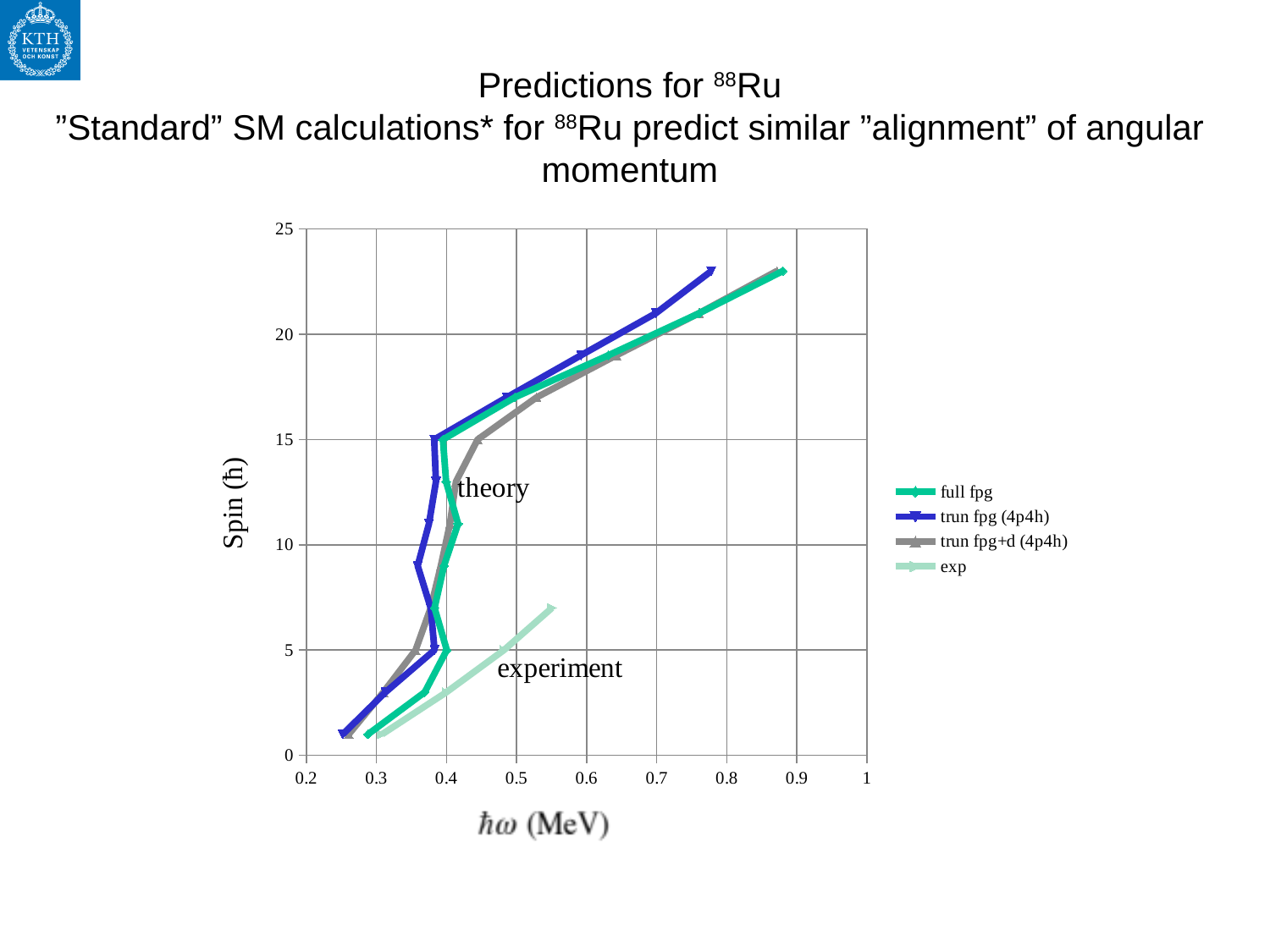
Is the ħω value of the full fpg series at spin 23 greater or less than 0.8 MeV? greater What are the four series listed in the legend? full fpg, trun fpg (4p4h), trun fpg+d (4p4h), exp At spin 23, which series has the larger ħω value: full fpg or trun fpg (4p4h)? full fpg How many data points does the exp series have? 4 Is the ħω value of the trun fpg (4p4h) series at spin 23 greater or less than 0.7 MeV? greater Is the ħω value of the highest-spin point of the exp series greater or less than 0.5 MeV? greater How many series does the legend list? 4 What kind of chart is shown on the slide? line chart What is the label of the vertical axis? Spin (ħ) At spin 15, which series has the larger ħω value: trun fpg+d (4p4h) or trun fpg (4p4h)? trun fpg+d (4p4h) Overall, does spin rise or fall as ħω increases along the x axis? rise